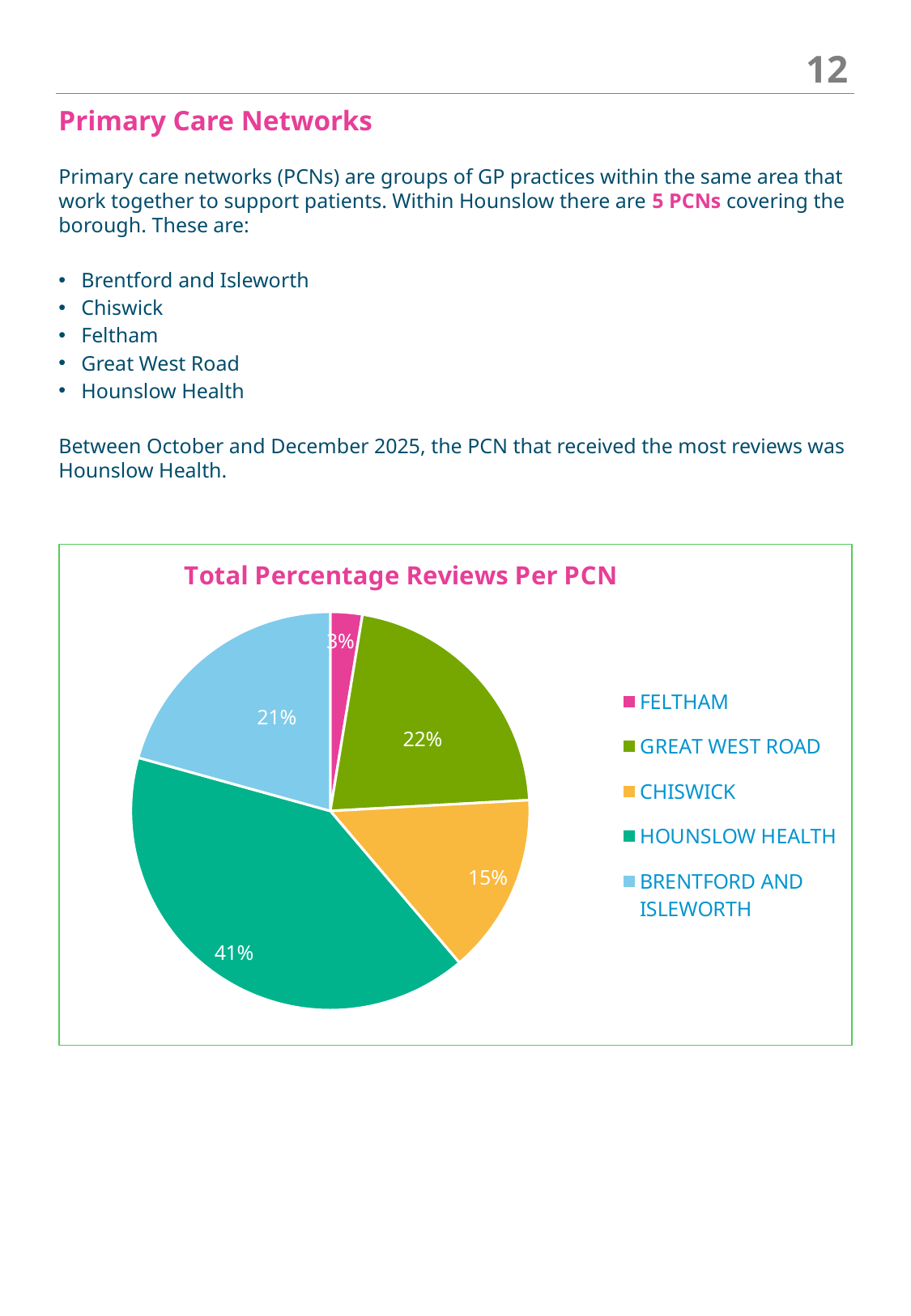
What is the title of the chart? Total Percentage Reviews Per PCN Which PCN has the smallest share of reviews? Feltham What percentage of reviews does Chiswick account for? 15% How many PCNs are shown in the pie chart? 5 What percentage of reviews does Brentford and Isleworth account for? 21% What type of chart is shown on the slide? Pie chart What percentage of reviews does Hounslow Health account for? 41% What colour is the Hounslow Health slice in the pie chart? Teal green Which PCN has the largest share of reviews? Hounslow Health Which has a larger share of reviews, Chiswick or Brentford and Isleworth? Brentford and Isleworth What percentage of reviews does Great West Road account for? 22% What is the difference in percentage points between Hounslow Health and Great West Road? 19